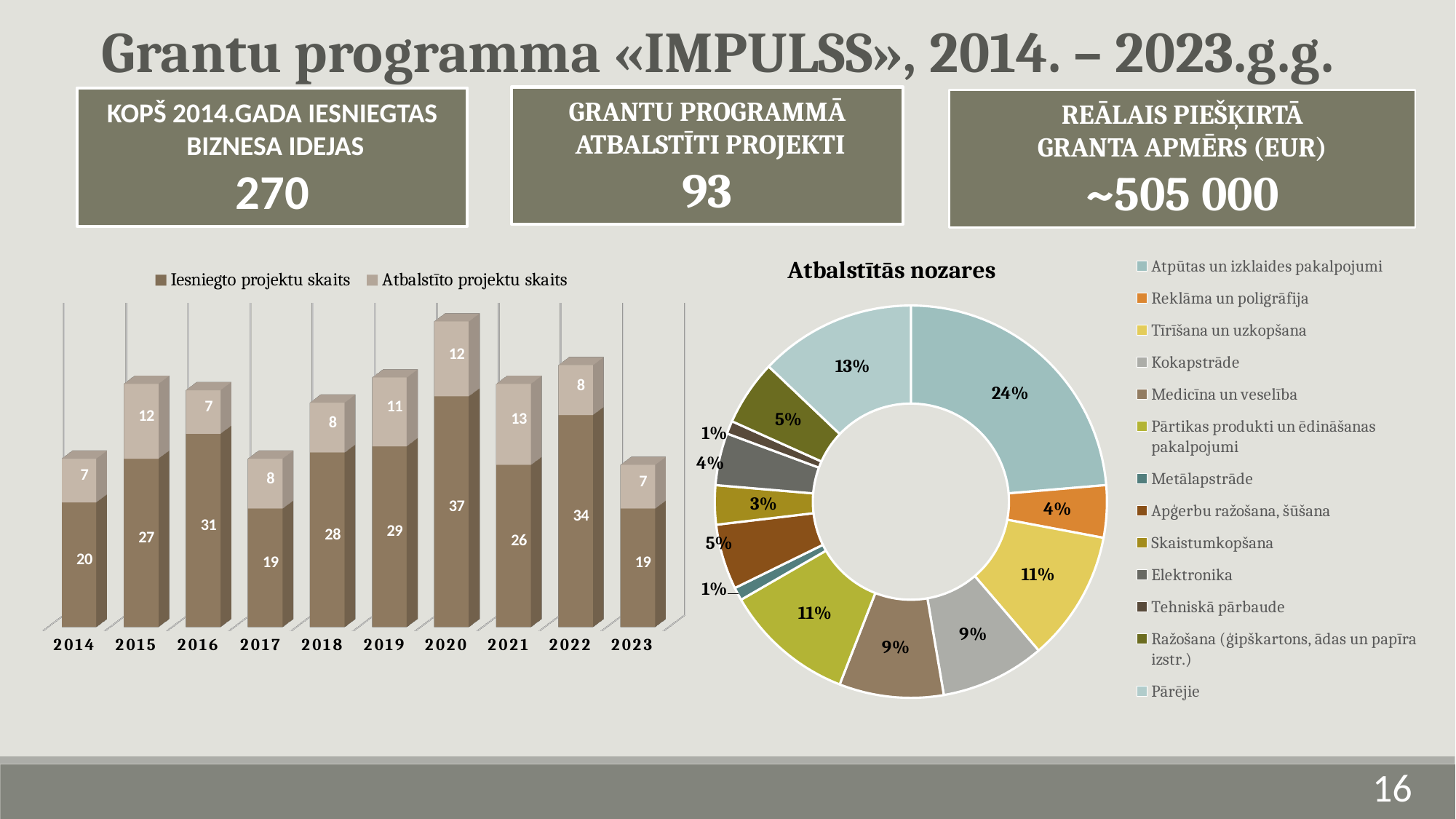
In the bar chart on the left, which year has the highest Iesniegto projektu skaits? 2020 In the chart titled Atbalstītās nozares, what share does Atpūtas un izklaides pakalpojumi have? 24% In the bar chart on the left, how many series does the legend list? 2 In the bar chart on the left, what is the total of the stacked bar for 2015? 39 In the bar chart on the left, which is larger: Iesniegto projektu skaits in 2016 or in 2018? 2016 In the bar chart on the left, how many years are shown on the x axis? 10 In the chart titled Atbalstītās nozares, what share does Pārējie have? 13% In the bar chart on the left, what is the value of Atbalstīto projektu skaits for 2021? 13 In the chart titled Atbalstītās nozares, which sector has the largest share? Atpūtas un izklaides pakalpojumi In the bar chart on the left, what is the difference between Iesniegto projektu skaits in 2022 and in 2023? 15 What kind of chart is the chart titled Atbalstītās nozares? Doughnut chart In the bar chart on the left, what is the value of Iesniegto projektu skaits for 2020? 37